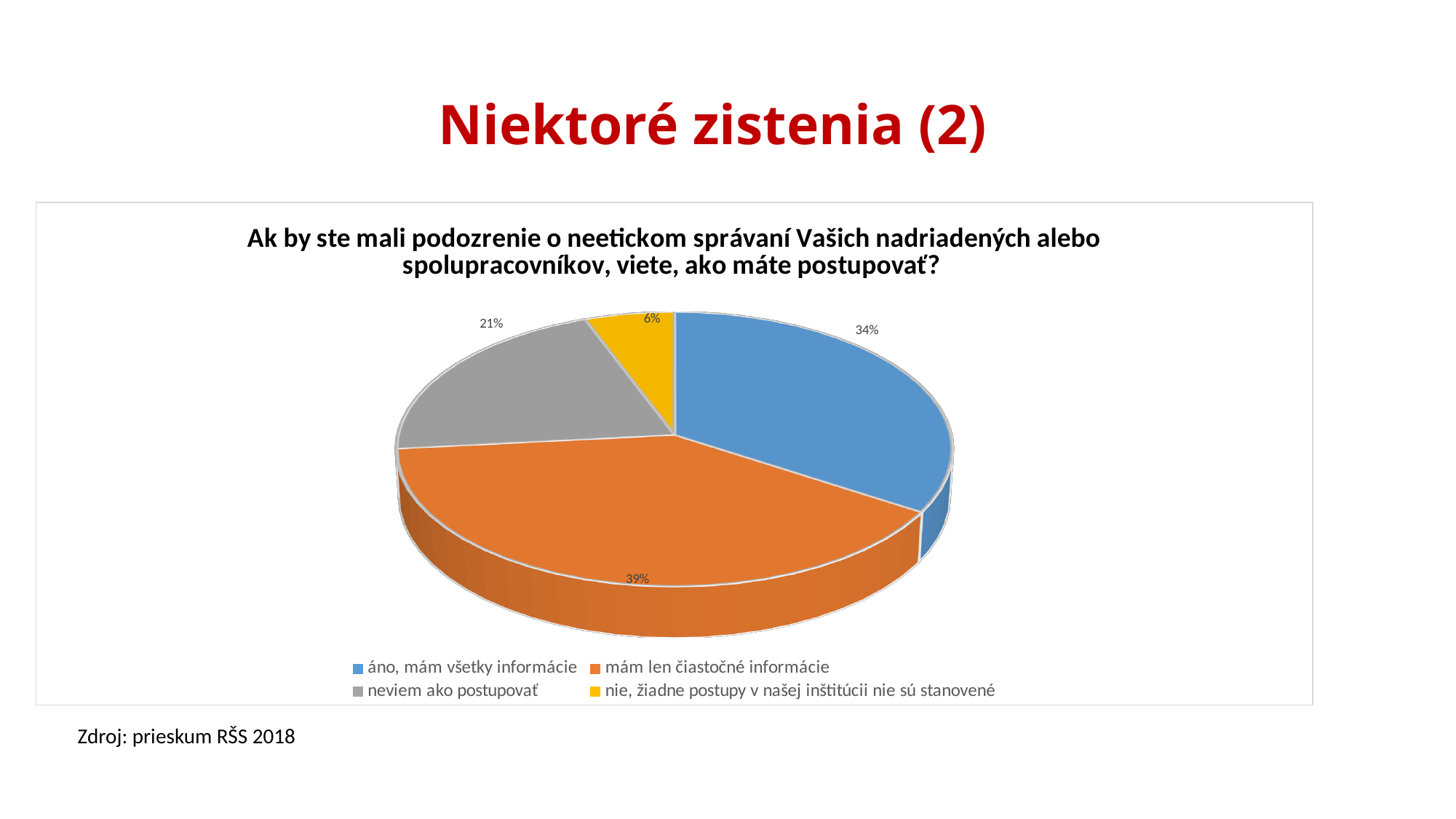
What is the difference in percentage points between "mám len čiastočné informácie" and "áno, mám všetky informácie"? 5 What source is cited below the chart? Zdroj: prieskum RŠS 2018 What kind of chart is shown on the slide? pie chart How many categories does the pie chart have? 4 Which is larger: the share for "neviem ako postupovať" or the share for "nie, žiadne postupy v našej inštitúcii nie sú stanovené"? neviem ako postupovať What share of the pie does "áno, mám všetky informácie" represent? 34% Which category has the largest slice of the pie? mám len čiastočné informácie What share of the pie does "nie, žiadne postupy v našej inštitúcii nie sú stanovené" represent? 6% Which category has the smallest slice of the pie? nie, žiadne postupy v našej inštitúcii nie sú stanovené What colour is the slice for "neviem ako postupovať"? grey What share of the pie does "neviem ako postupovať" represent? 21%